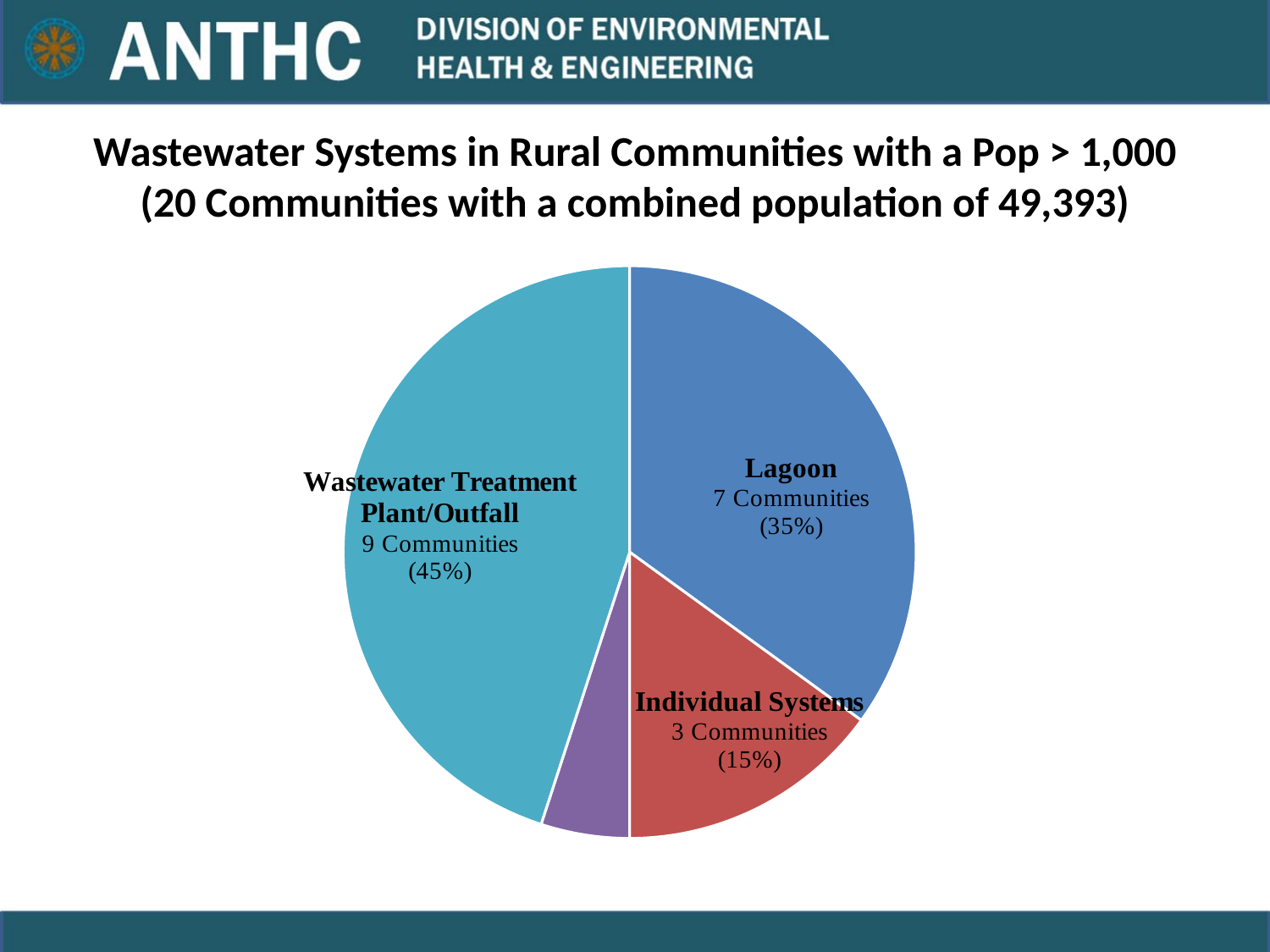
Which labeled wastewater system type has the smallest slice of the pie? Individual Systems What percentage of communities use a Wastewater Treatment Plant/Outfall? 45% How many slices does the pie chart have? 4 How many more communities use a Wastewater Treatment Plant/Outfall than a Lagoon? 2 How many communities use a Lagoon wastewater system? 7 Communities Which labeled wastewater system type has the largest slice of the pie? Wastewater Treatment Plant/Outfall What is the difference in percentage points between the Lagoon slice and the Individual Systems slice? 20 What kind of chart is shown on the slide? pie chart Which has more communities, Lagoon or Individual Systems? Lagoon How many communities use Individual Systems? 3 Communities What is the title of the chart on the slide? Wastewater Systems in Rural Communities with a Pop > 1,000 (20 Communities with a combined population of 49,393) What share of the pie does the Lagoon slice represent? 35%